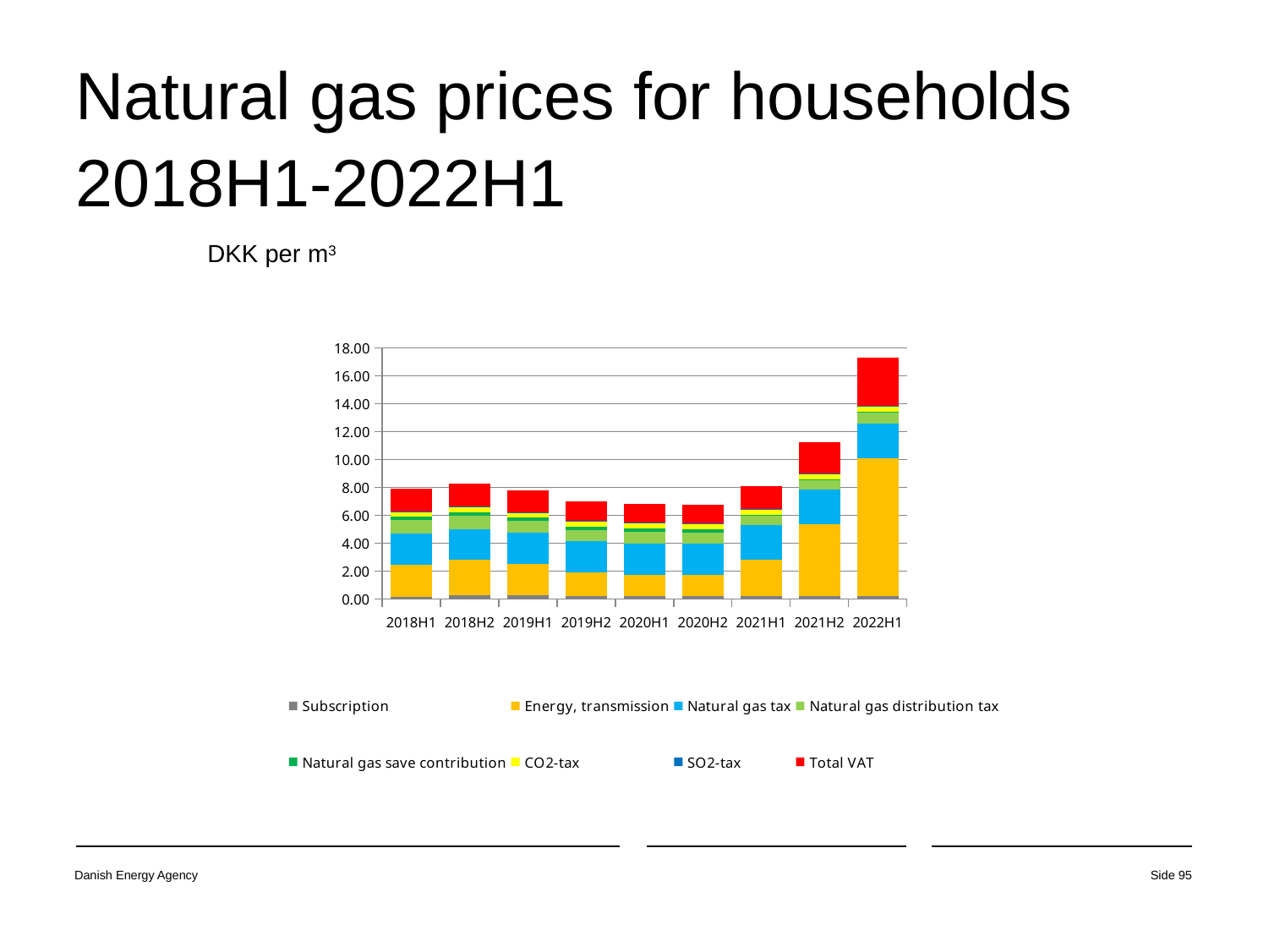
Is the Energy, transmission component for 2022H1 greater or less than 8.00? greater Which period has the highest total natural gas price? 2022H1 What unit is the chart measured in? DKK per m³ Do the total prices rise or fall from 2020H2 to 2022H1? Rise Is the total value for 2022H1 greater or less than 16.00? greater Which period has the larger total price, 2021H2 or 2022H1? 2022H1 Which colour represents Total VAT in the legend? Red Is the total value for 2021H2 greater or less than 10.00? greater How many series does the legend list? 8 How many periods (categories) are shown on the x axis? 9 What kind of chart is shown on the slide? Stacked bar chart